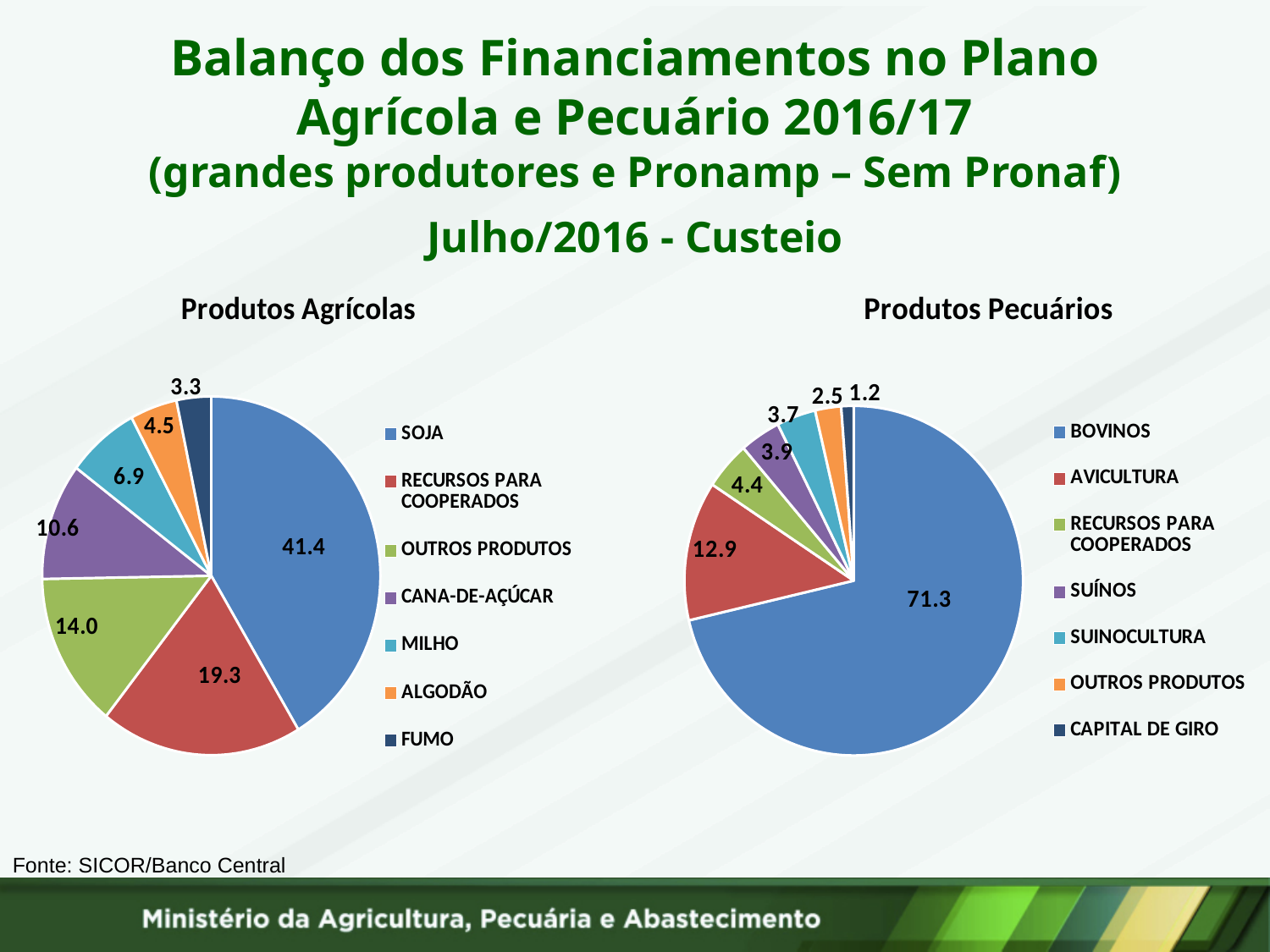
In the Produtos Agrícolas pie chart, what is the value for SOJA? 41.4 In the Produtos Pecuários pie chart, what colour is the BOVINOS slice? Blue How many categories does the Produtos Pecuários pie chart show? 7 In the Produtos Agrícolas pie chart, which category has the smallest slice? FUMO In the Produtos Pecuários pie chart, what is the value for AVICULTURA? 12.9 In the Produtos Pecuários pie chart, which category has the largest slice? BOVINOS In the Produtos Pecuários pie chart, what is the difference between the values for BOVINOS and AVICULTURA? 58.4 In the Produtos Agrícolas pie chart, which is larger: MILHO or ALGODÃO? MILHO In the Produtos Agrícolas pie chart, what is the value for CANA-DE-AÇÚCAR? 10.6 In the Produtos Pecuários pie chart, what is the value for CAPITAL DE GIRO? 1.2 In the Produtos Agrícolas pie chart, what is the difference between the values for SOJA and RECURSOS PARA COOPERADOS? 22.1 What type of chart is used for Produtos Agrícolas? Pie chart